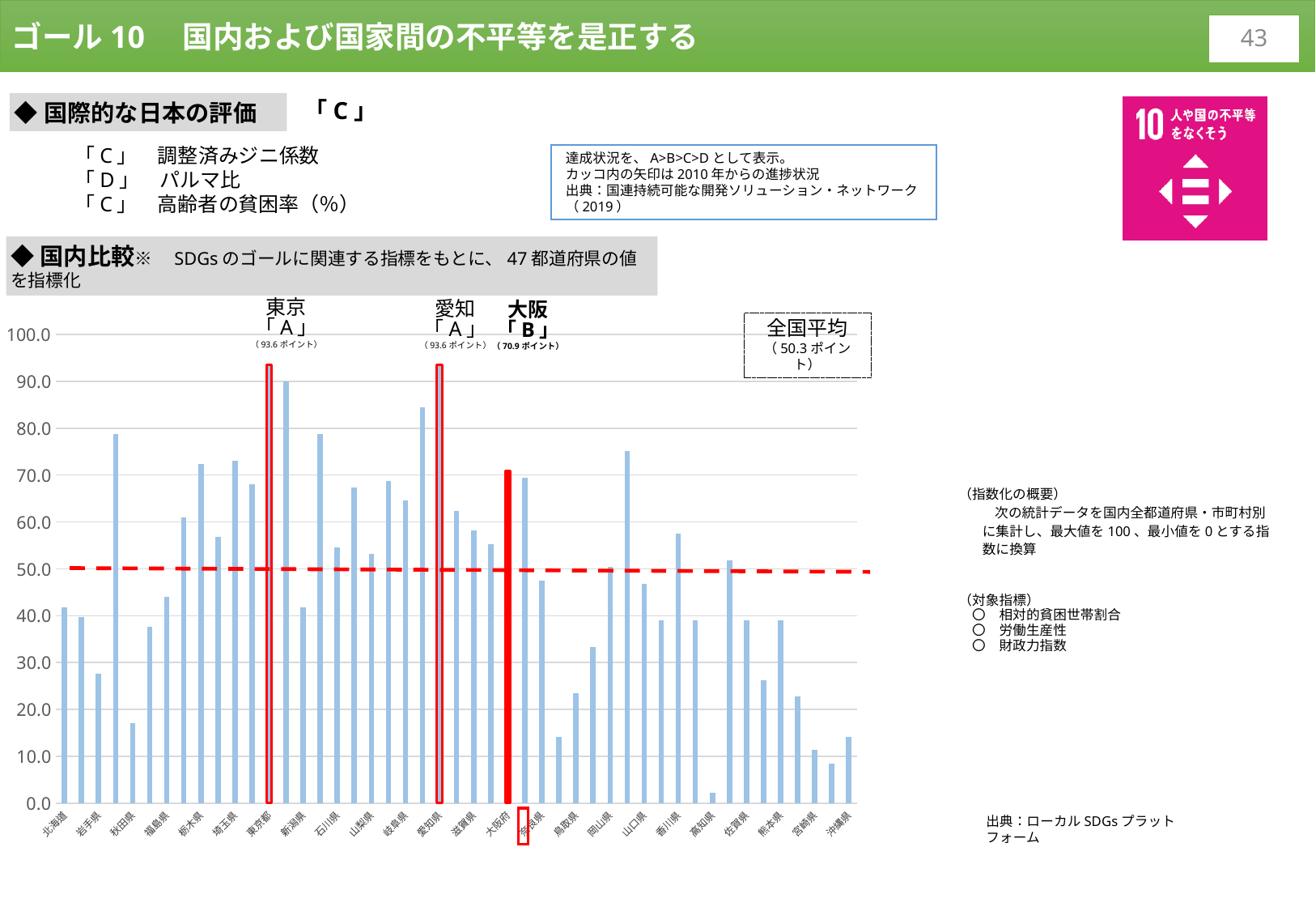
Which has the larger value, 東京 or 大阪? 東京 How many prefectures are plotted in the bar chart? 47 Is the value for 岡山県 greater or less than 40? greater What is the difference between the values for 東京 and 大阪? 22.7 ポイント What kind of chart is used to show the prefecture comparison? bar chart What is the 全国平均 value shown on the chart? 50.3 ポイント What is the value shown for 東京 in the bar chart? 93.6 ポイント What is the value shown for 大阪 in the bar chart? 70.9 ポイント Is the value for 沖縄県 greater or less than 20? less Which has the larger value, 北海道 or 沖縄県? 北海道 What does the red dashed horizontal line on the chart represent? 全国平均 Is the value for 北海道 greater or less than 50? less